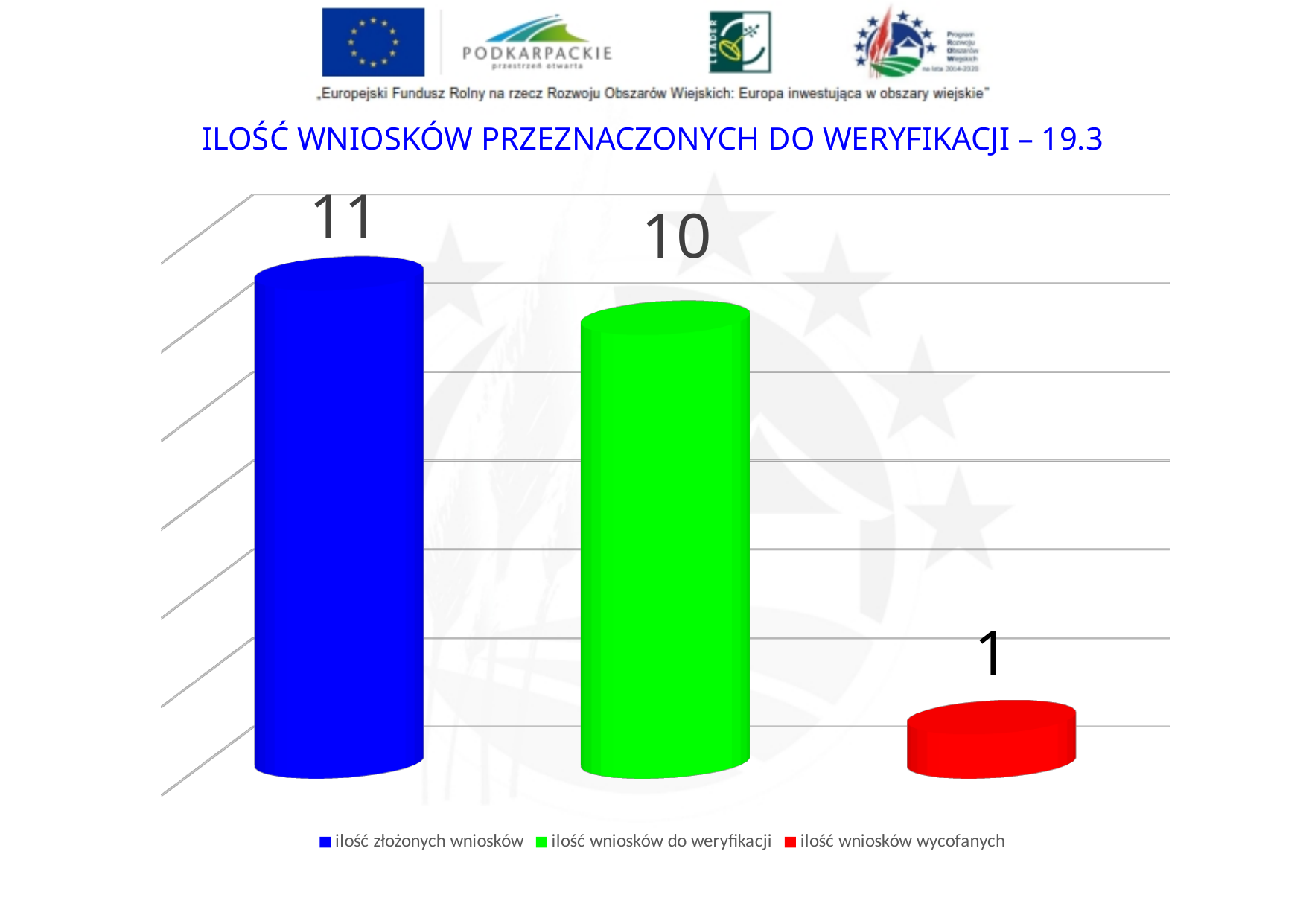
What is the value for 'ilość złożonych wniosków'? 11 Which series has the lowest value? ilość wniosków wycofanych What colour is the bar for 'ilość wniosków wycofanych'? red What is the difference between 'ilość złożonych wniosków' and 'ilość wniosków do weryfikacji'? 1 How many bars are plotted in the chart? 3 How many series does the legend list? 3 What kind of chart is shown on the slide? bar chart Which is larger: 'ilość wniosków do weryfikacji' or 'ilość wniosków wycofanych'? ilość wniosków do weryfikacji What is the difference between 'ilość wniosków do weryfikacji' and 'ilość wniosków wycofanych'? 9 Which series has the highest value? ilość złożonych wniosków What is the value for 'ilość wniosków wycofanych'? 1 What is the value for 'ilość wniosków do weryfikacji'? 10